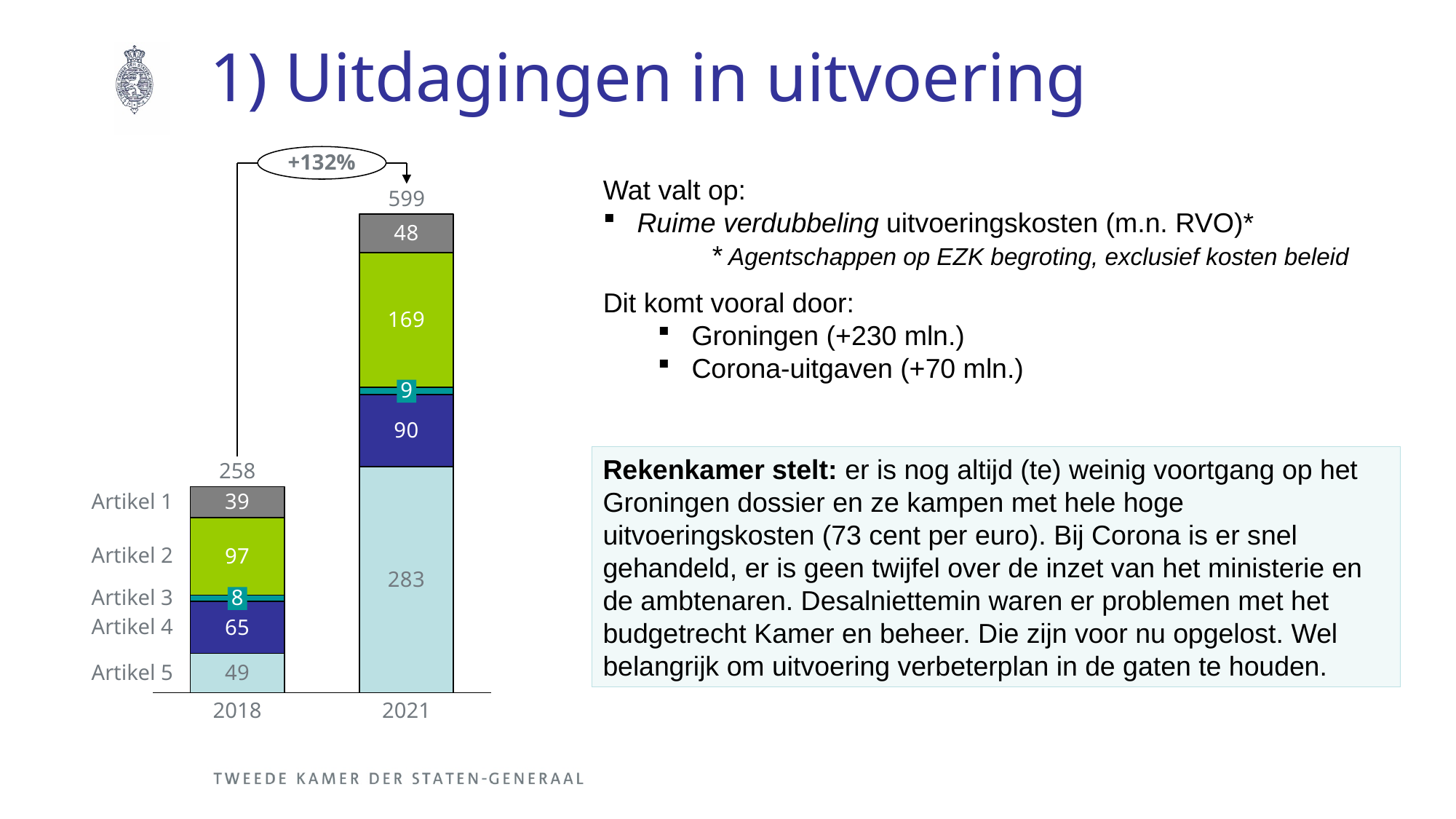
What is the value for Artikel 3 in 2021? 9 What is the difference between the Artikel 4 values for 2021 and 2018? 25 What is the value for Artikel 2 in 2018? 97 Which year has the higher total, 2018 or 2021? 2021 How many years (bars) are shown on the x axis? 2 What is the total of the 2018 stacked bar? 258 What percentage increase is shown in the annotation above the bars? +132% What is the value for Artikel 5 in 2021? 283 Which Artikel has the smallest value in the 2018 bar? Artikel 3 What is the total of the 2021 stacked bar? 599 Which Artikel has the largest value in the 2021 bar? Artikel 5 What type of chart is shown on the slide? Stacked bar chart